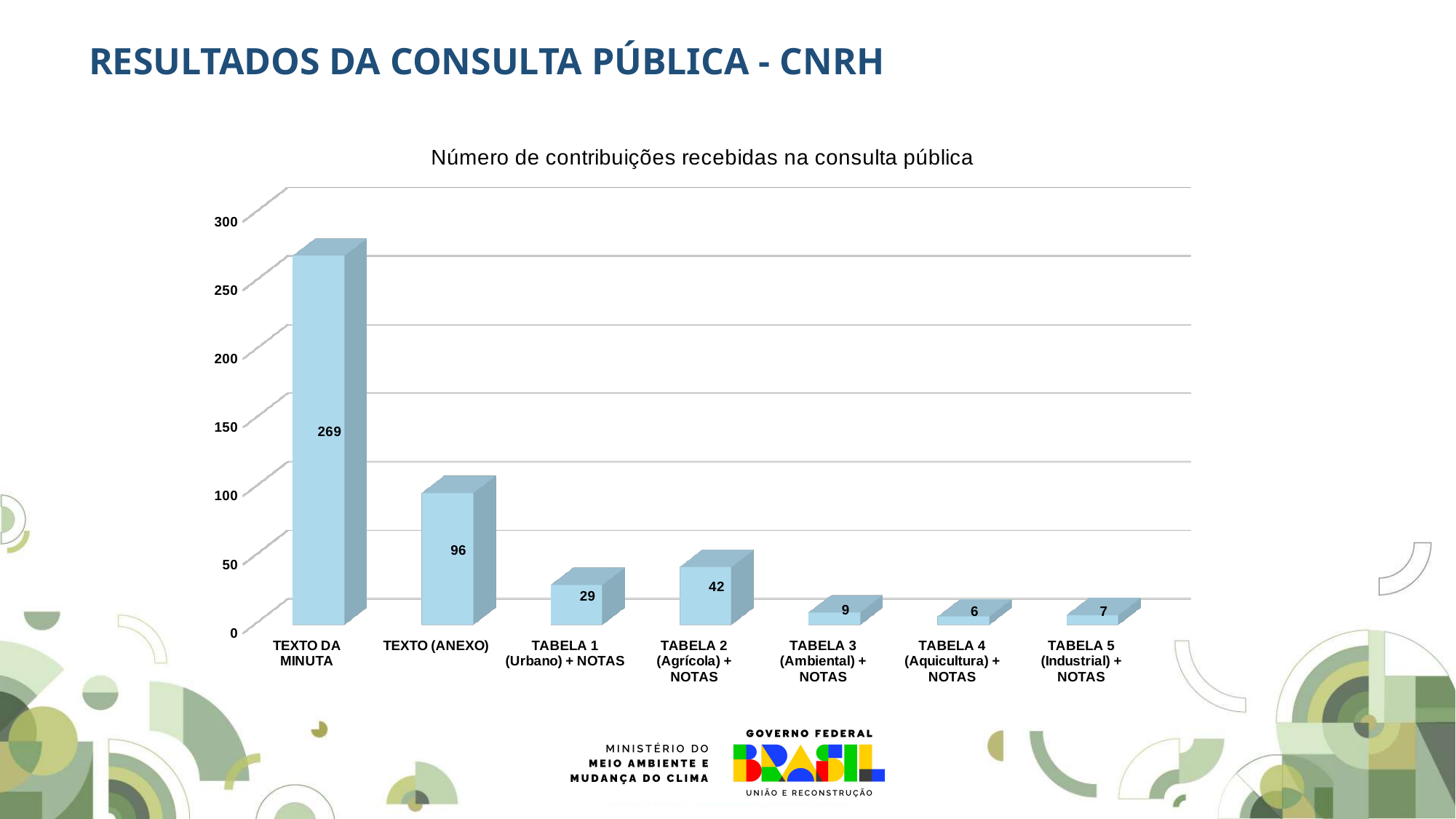
What is the value for TABELA 2 (Agrícola) + NOTAS? 42 Which category has the highest value? TEXTO DA MINUTA What is the difference between the values for TEXTO DA MINUTA and TEXTO (ANEXO)? 173 How many categories are shown on the x axis? 7 What is the title of the chart? Número de contribuições recebidas na consulta pública What is the difference between the values for TABELA 2 (Agrícola) + NOTAS and TABELA 1 (Urbano) + NOTAS? 13 Which category has the lowest value? TABELA 4 (Aquicultura) + NOTAS Is the value for TEXTO (ANEXO) greater or less than 100? less What kind of chart is shown on the slide? bar chart Which is larger, the value for TABELA 1 (Urbano) + NOTAS or TABELA 2 (Agrícola) + NOTAS? TABELA 2 (Agrícola) + NOTAS What is the value for TEXTO DA MINUTA? 269 What is the value for TABELA 4 (Aquicultura) + NOTAS? 6